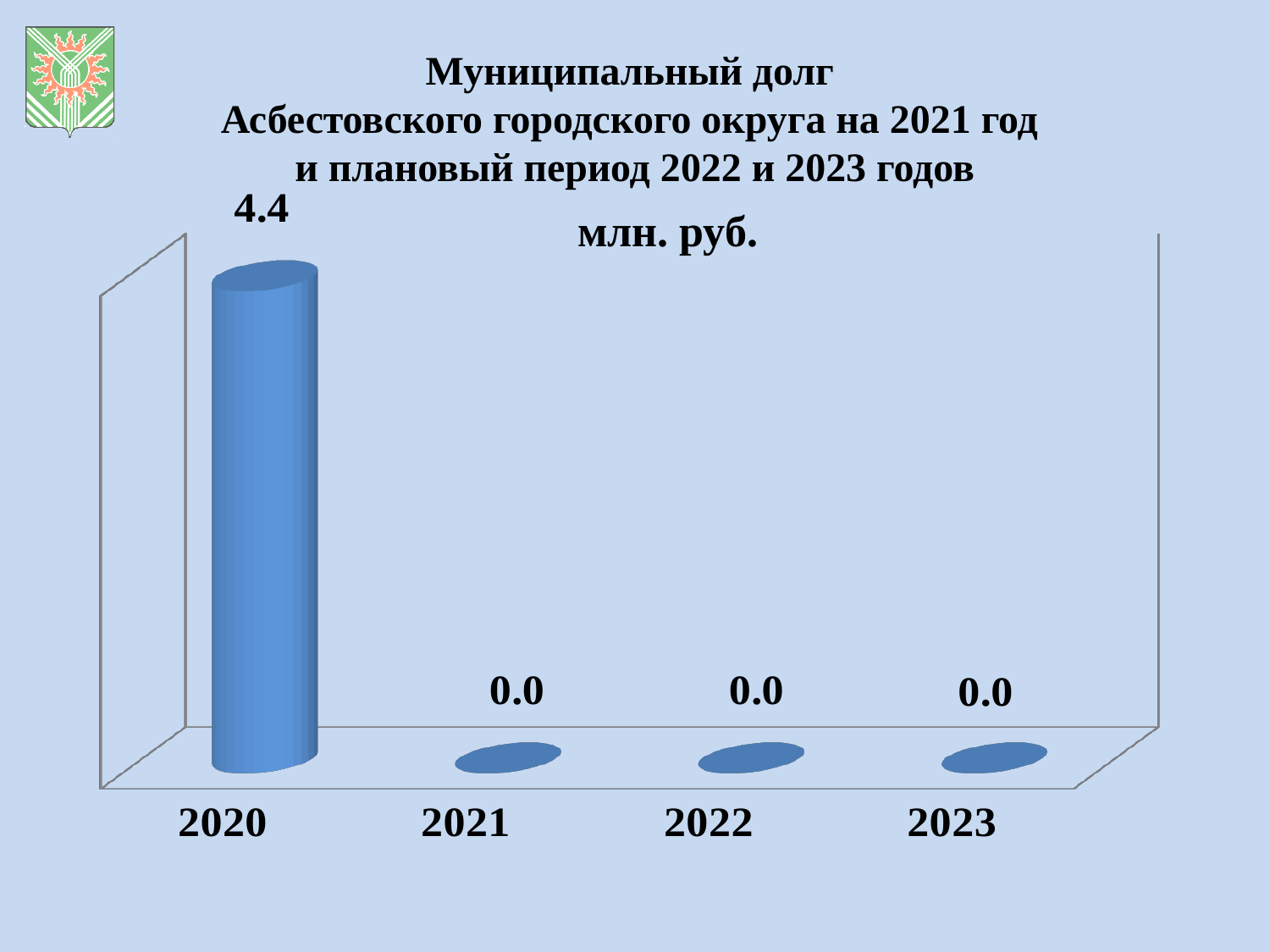
What is the difference between the values for 2020 and 2021? 4.4 What is the municipal debt value shown for 2021? 0.0 Which is larger, the value for 2020 or the value for 2022? 2020 What is the municipal debt value shown for 2023? 0.0 Which year has the highest municipal debt value? 2020 Do the values rise or fall from 2020 to 2021? fall What is the municipal debt value shown for 2020? 4.4 What kind of chart is shown on the slide? bar chart How many years show a value of 0.0? 3 What unit of measurement is stated for the chart values? млн. руб. How many years are shown on the x axis of the chart? 4